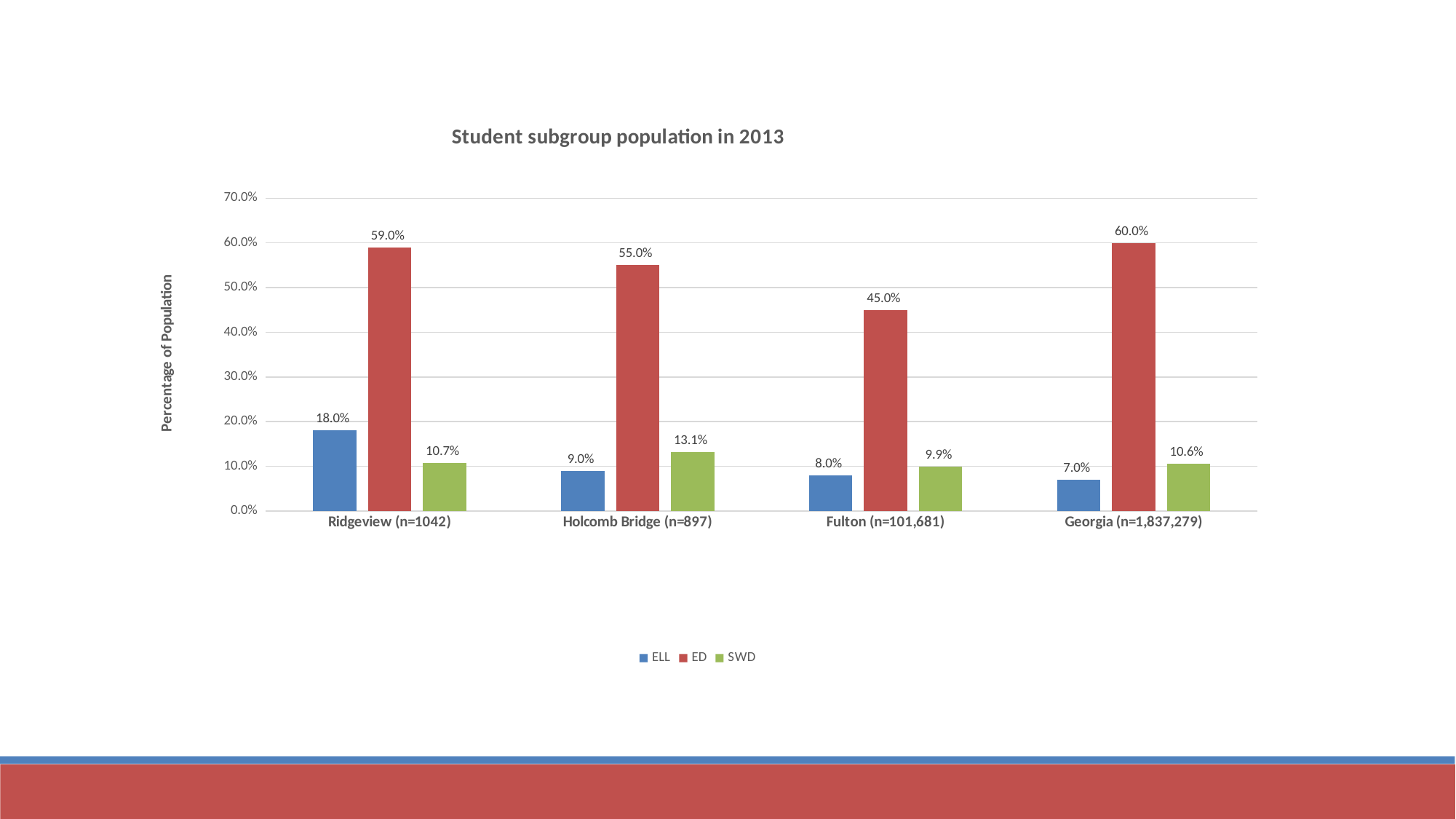
What is the SWD value for Holcomb Bridge (n=897)? 13.1% Which category has the highest ED value? Georgia (n=1,837,279) What kind of chart is shown on the slide? Bar chart What is the difference between the ED values for Georgia (n=1,837,279) and Fulton (n=101,681)? 15.0% What is the title of the chart? Student subgroup population in 2013 How many series does the legend list? 3 What is the ELL value for Georgia (n=1,837,279)? 7.0% How many categories are shown on the x axis? 4 What is the label of the vertical axis? Percentage of Population What is the ED value for Ridgeview (n=1042)? 59.0% Which category has the lowest ELL value? Georgia (n=1,837,279) Which is larger, the SWD value for Ridgeview (n=1042) or the SWD value for Fulton (n=101,681)? Ridgeview (n=1042)